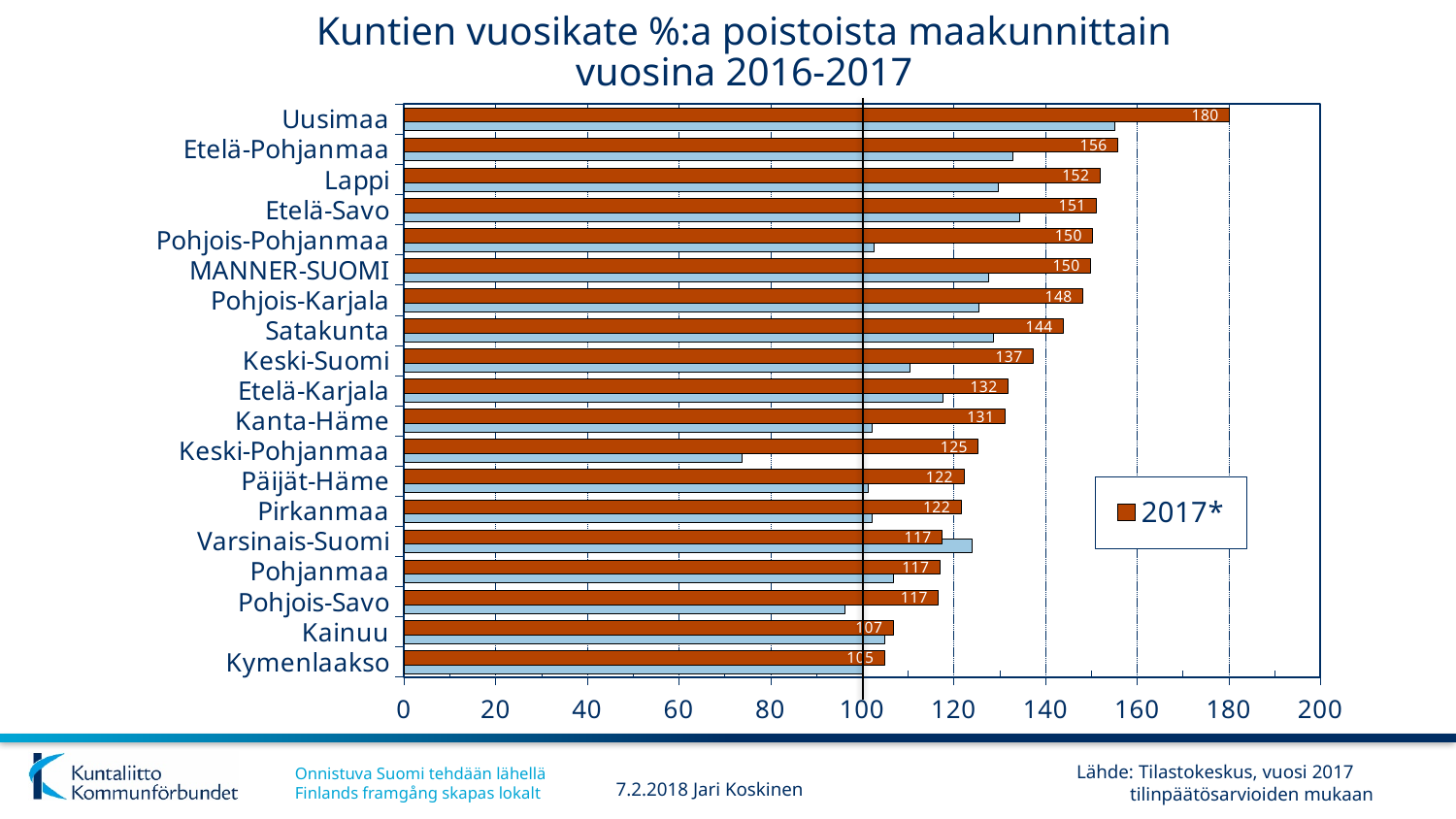
Which region has the highest 2017* value? Uusimaa What is the 2017* value for MANNER-SUOMI? 150 What kind of chart is shown on the slide? Bar chart What is the 2017* value for Uusimaa? 180 Which region has the lowest 2017* value? Kymenlaakso What is the difference between the 2017* values for Uusimaa and Kymenlaakso? 75 How many series does the legend list? 1 Is the value of the lighter (unlabeled) bar for Keski-Pohjanmaa greater or less than 80? less How many regions are listed on the chart? 19 Which has a larger 2017* value, Lappi or Satakunta? Lappi What is the 2017* value for Keski-Suomi? 137 What is the 2017* value for Kymenlaakso? 105